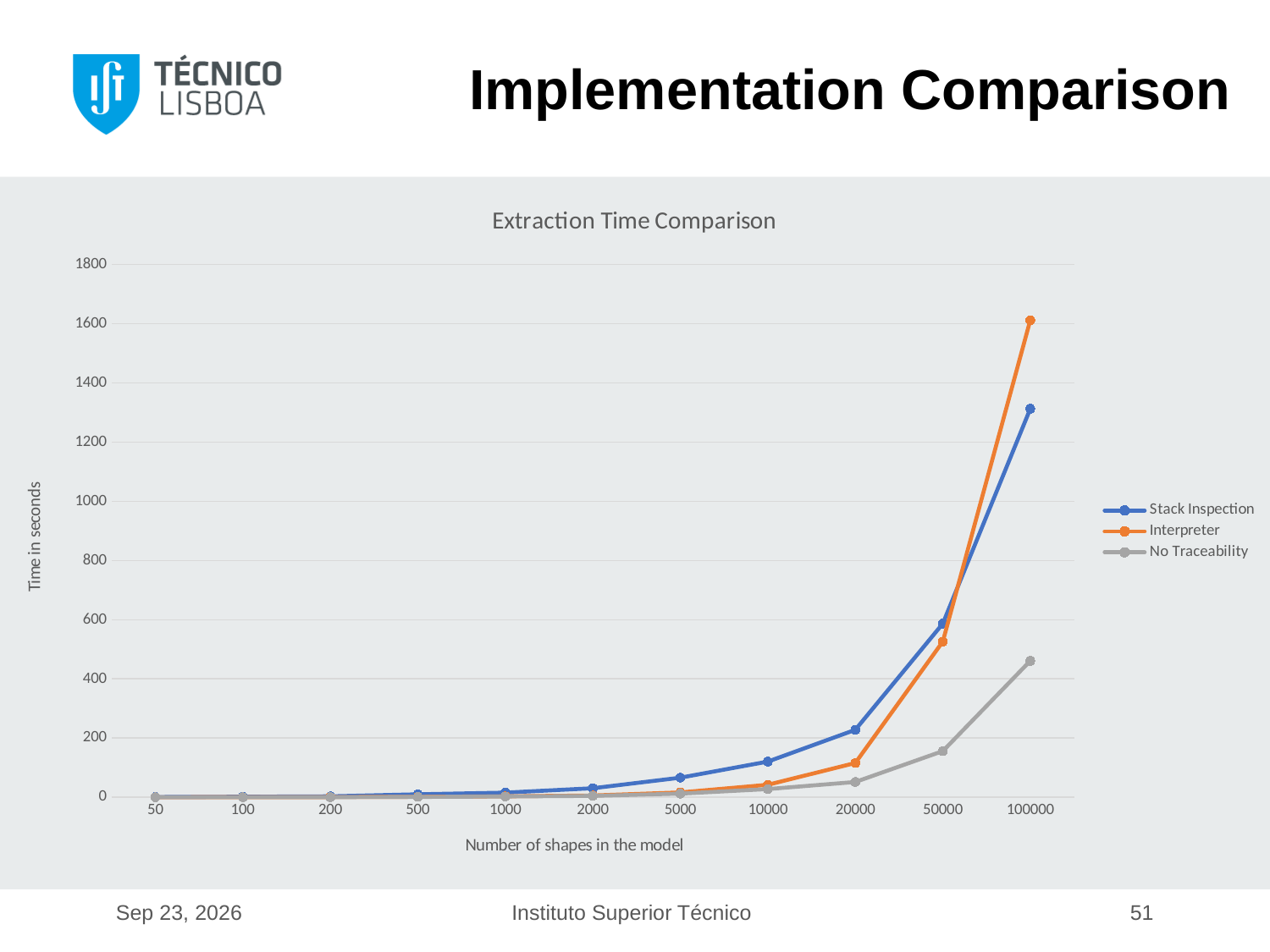
Is the value for Stack Inspection at 100000 shapes greater or less than 1400? less At 20000 shapes, which is larger: Stack Inspection or Interpreter? Stack Inspection Is the value for No Traceability at 50000 shapes greater or less than 200? less Do the values for Stack Inspection rise or fall as the number of shapes increases? Rise Is the value for Interpreter at 100000 shapes greater or less than 1400? greater How many series does the legend list? 3 Which series has the highest value at 100000 shapes? Interpreter What kind of chart is shown on the slide? Line chart How many points are shown along the x axis (number of shapes in the model)? 11 What is the label of the y axis? Time in seconds What is the title of the chart? Extraction Time Comparison Which series has the lowest value at 100000 shapes? No Traceability